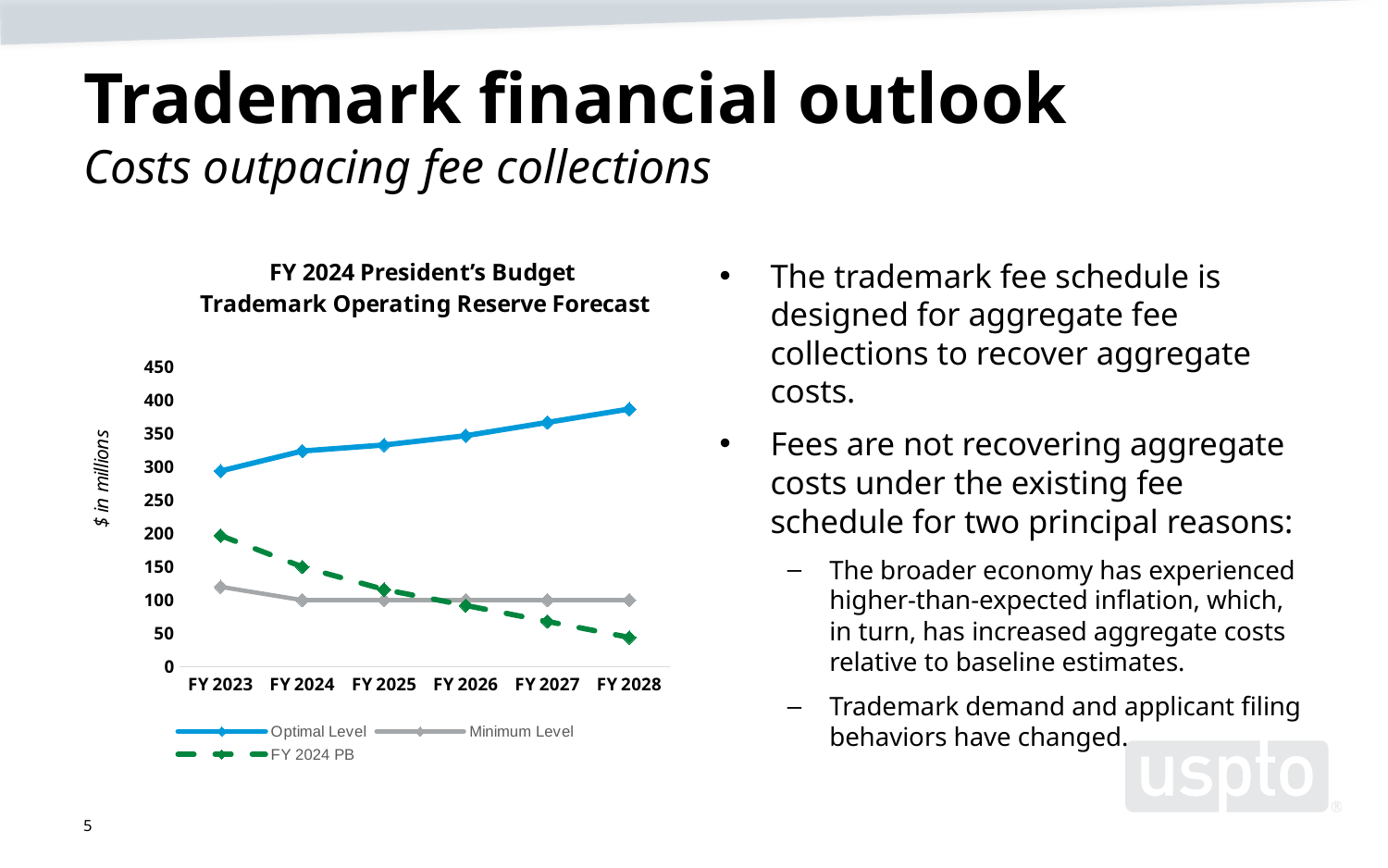
In FY 2027, which is larger: the Minimum Level or the FY 2024 PB value? Minimum Level What kind of chart is shown on the slide? line chart Is the FY 2024 PB value for FY 2023 greater or less than 150? greater How many fiscal years are plotted along the x axis? 6 Does the FY 2024 PB series rise or fall from FY 2023 to FY 2028? fall What is the label on the chart's vertical axis? $ in millions How many series does the chart's legend list? 3 In which fiscal year is the FY 2024 PB series at its highest? FY 2023 Is the FY 2024 PB value for FY 2028 greater or less than 100? less Does the Optimal Level series rise or fall from FY 2023 to FY 2028? rise In which fiscal year is the Optimal Level series at its lowest? FY 2023 Is the Optimal Level value for FY 2028 greater or less than 350? greater